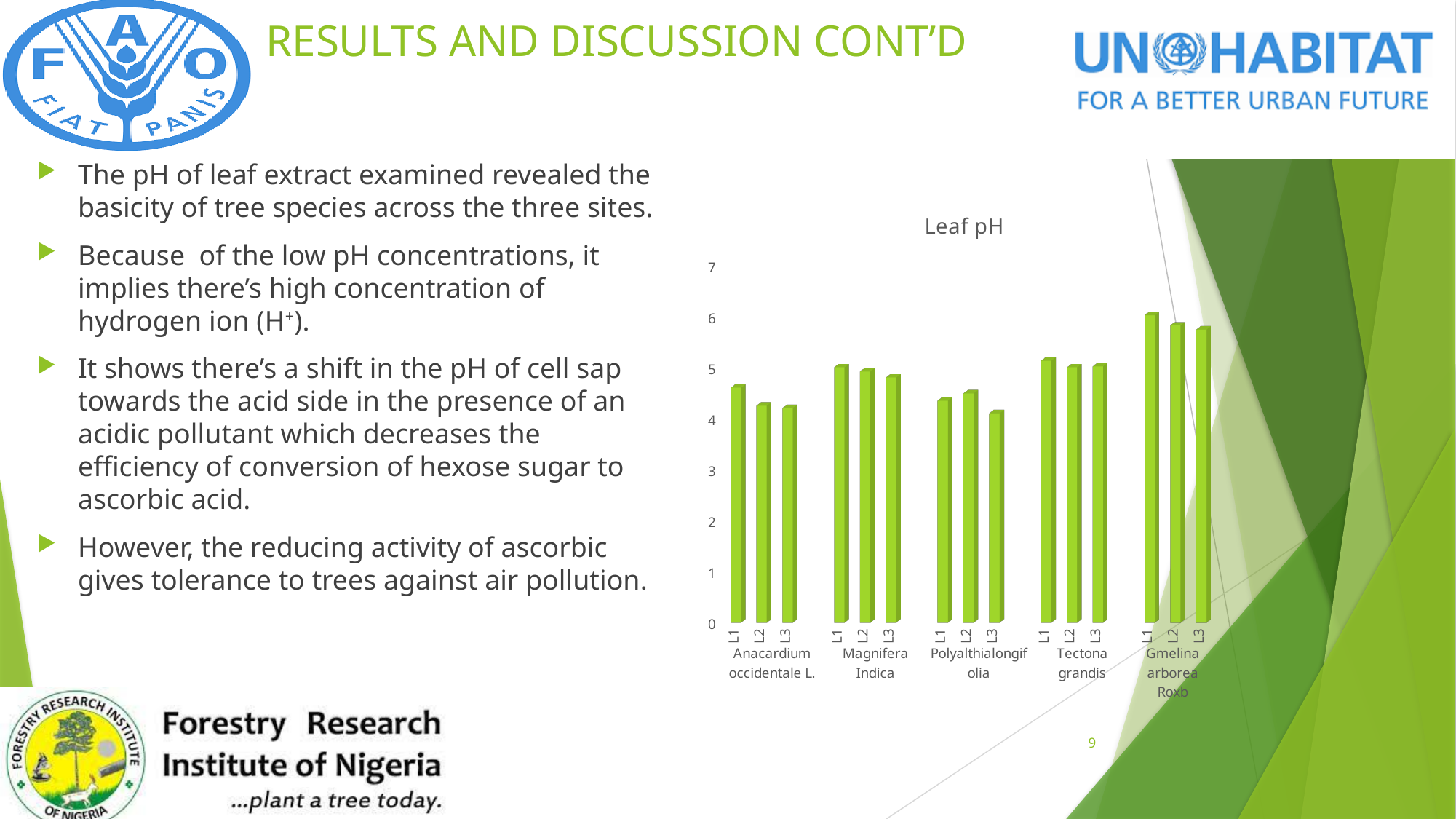
Which bar is the highest in the Leaf pH chart? Gmelina arborea Roxb L1 What is the title of the chart? Leaf pH What kind of chart is shown on the slide? bar chart Is the leaf pH value for Gmelina arborea Roxb L1 greater or less than 5? greater What is the highest tick value shown on the vertical axis of the Leaf pH chart? 7 Do the leaf pH values for Gmelina arborea Roxb rise or fall from L1 to L3? fall Is the leaf pH value for Polyalthialongifolia L3 greater or less than 5? less Which tree species has the highest leaf pH values overall? Gmelina arborea Roxb How many bars are plotted in the Leaf pH chart? 15 Which is larger, the leaf pH for Gmelina arborea Roxb L1 or for Anacardium occidentale L. L1? Gmelina arborea Roxb L1 Is the leaf pH value for Anacardium occidentale L. L3 greater or less than 5? less How many tree species are shown on the x axis of the Leaf pH chart? 5